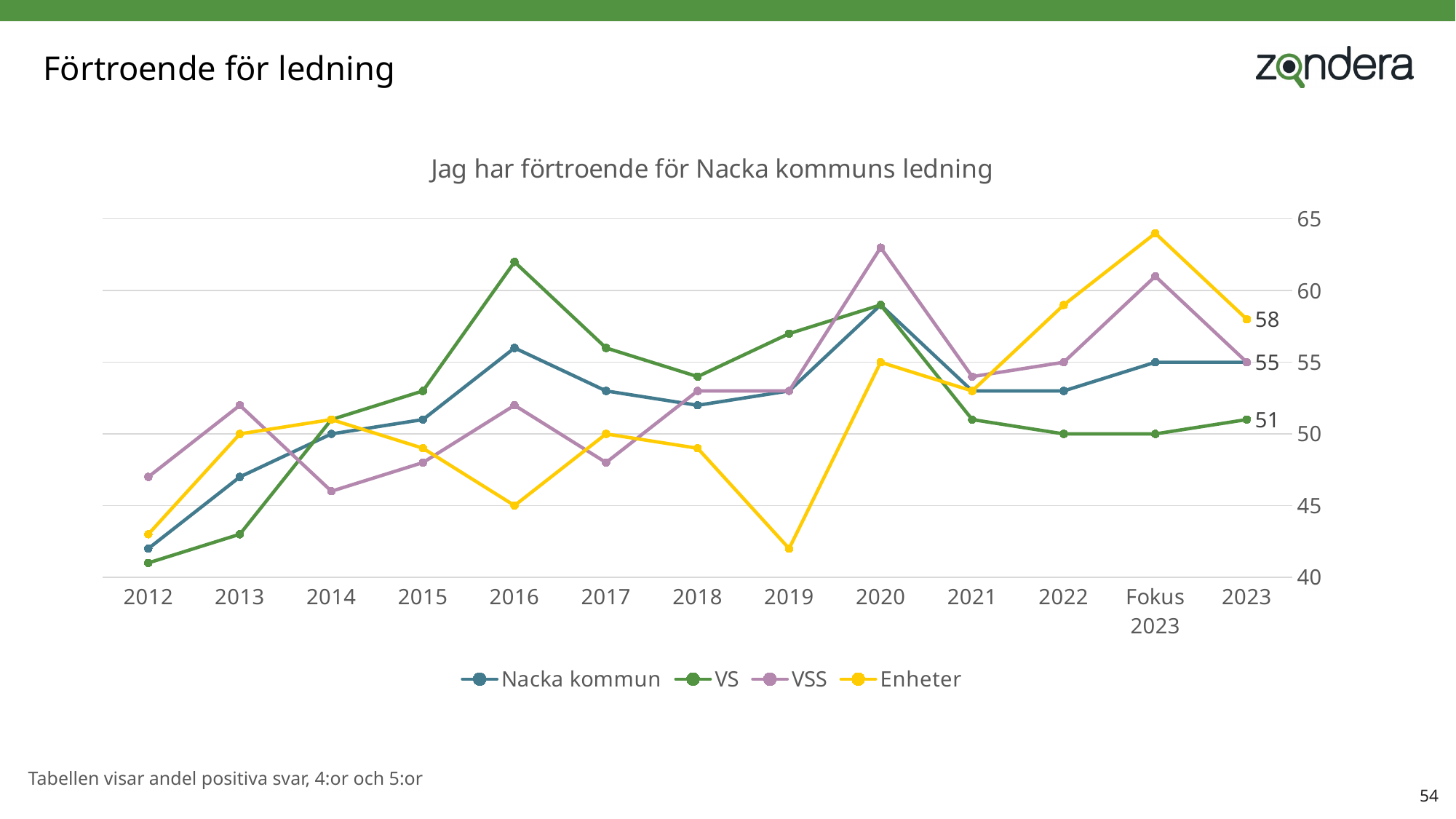
Is the value for Enheter in 2019 greater or less than 45? less How many series does the legend list? 4 In 2023, which is larger: the value for Enheter or the value for VS? Enheter In which year does the VS series have its lowest value? 2012 In which year does the Enheter series reach its highest value? Fokus 2023 What is the value for Nacka kommun in 2023? 55 Is the value for VS in 2016 greater or less than 60? greater How many points are there along the x axis? 13 What is the difference between the Enheter and VS values in 2023? 7 What is the value for VS in 2023? 51 What is the value for Enheter in 2023? 58 What type of chart is shown on the slide? line chart